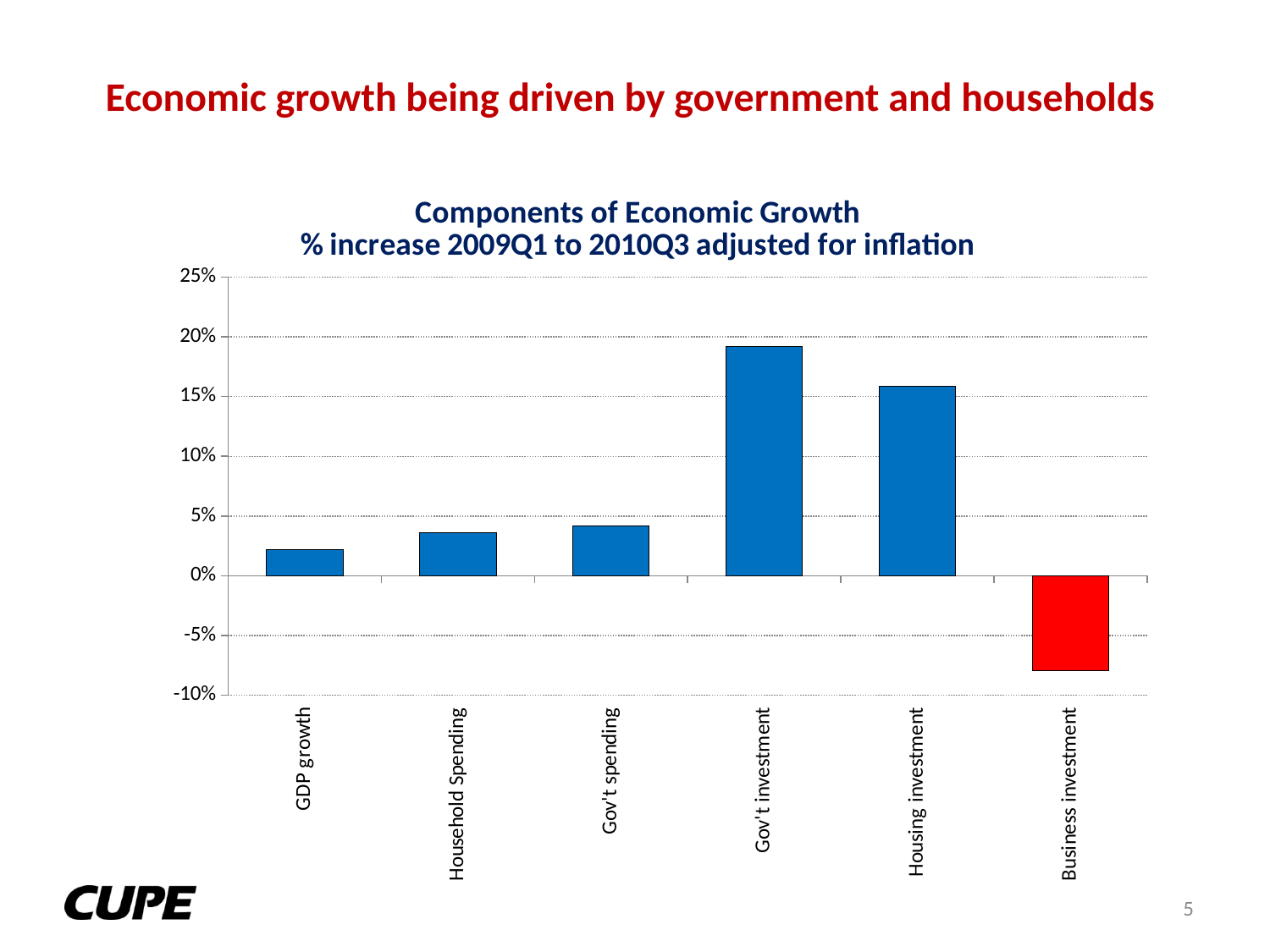
Is the value for Gov't investment greater or less than 15%? greater Which category has the lowest value? Business investment How many categories are plotted in the chart? 6 Is the value for Business investment greater or less than -5%? less Is the value for GDP growth greater or less than 5%? less Which is larger, the value for Gov't spending or the value for GDP growth? Gov't spending Which category is shown with a red bar? Business investment What is the title of the chart? Components of Economic Growth % increase 2009Q1 to 2010Q3 adjusted for inflation Which is larger, the value for Gov't investment or the value for Housing investment? Gov't investment Which category has the highest value? Gov't investment What kind of chart is shown on the slide? bar chart